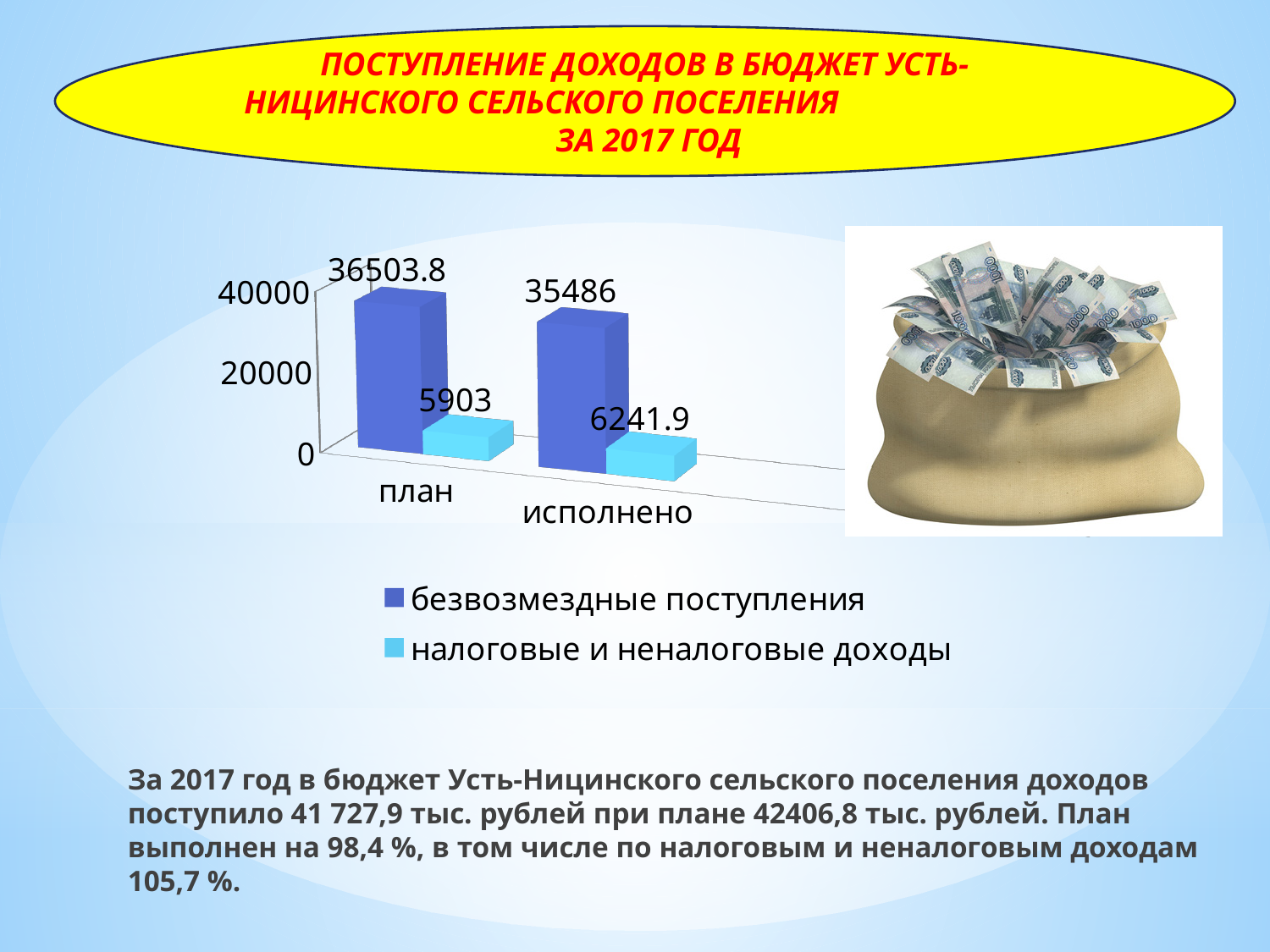
Is the value of безвозмездные поступления for план greater or less than 20000? greater What is the value of налоговые и неналоговые доходы for исполнено? 6241.9 Which category has the higher value for безвозмездные поступления, план or исполнено? план What type of chart is shown on the slide? bar chart What is the value of безвозмездные поступления for план? 36503.8 Which category has the higher value for налоговые и неналоговые доходы, план or исполнено? исполнено What is the value of налоговые и неналоговые доходы for план? 5903 What is the value of безвозмездные поступления for исполнено? 35486 How many categories are shown on the x axis of the chart? 2 How many series does the chart legend list? 2 What is the difference between the план and исполнено values for безвозмездные поступления? 1017.8 What is the difference between the исполнено and план values for налоговые и неналоговые доходы? 338.9